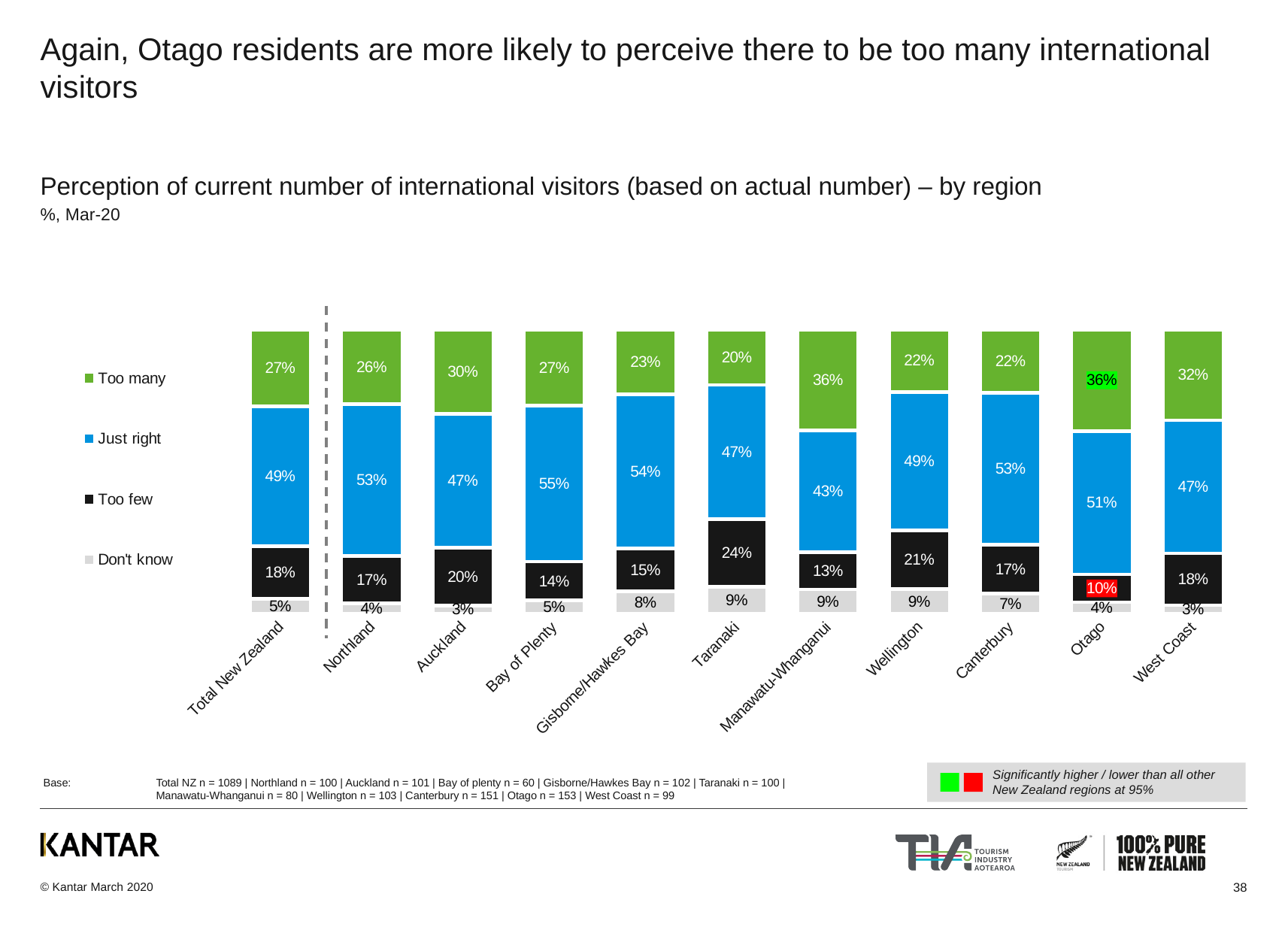
What kind of chart is shown on the slide? Stacked bar chart Which region has the highest 'Just right' value? Bay of Plenty What is the difference between the 'Too many' value for Otago and for Total New Zealand? 9 percentage points What is the 'Too many' value for Otago? 36% What is the 'Too few' value for Taranaki? 24% Which series is shown in green? Too many How many regions (including Total New Zealand) are plotted on the x axis? 11 Which region has the lowest 'Too many' value? Taranaki What is the 'Don't know' value for Gisborne/Hawkes Bay? 8% How many series does the legend list? 4 Which has the larger 'Just right' value, Northland or Auckland? Northland Which region has the lowest 'Too few' value? Otago